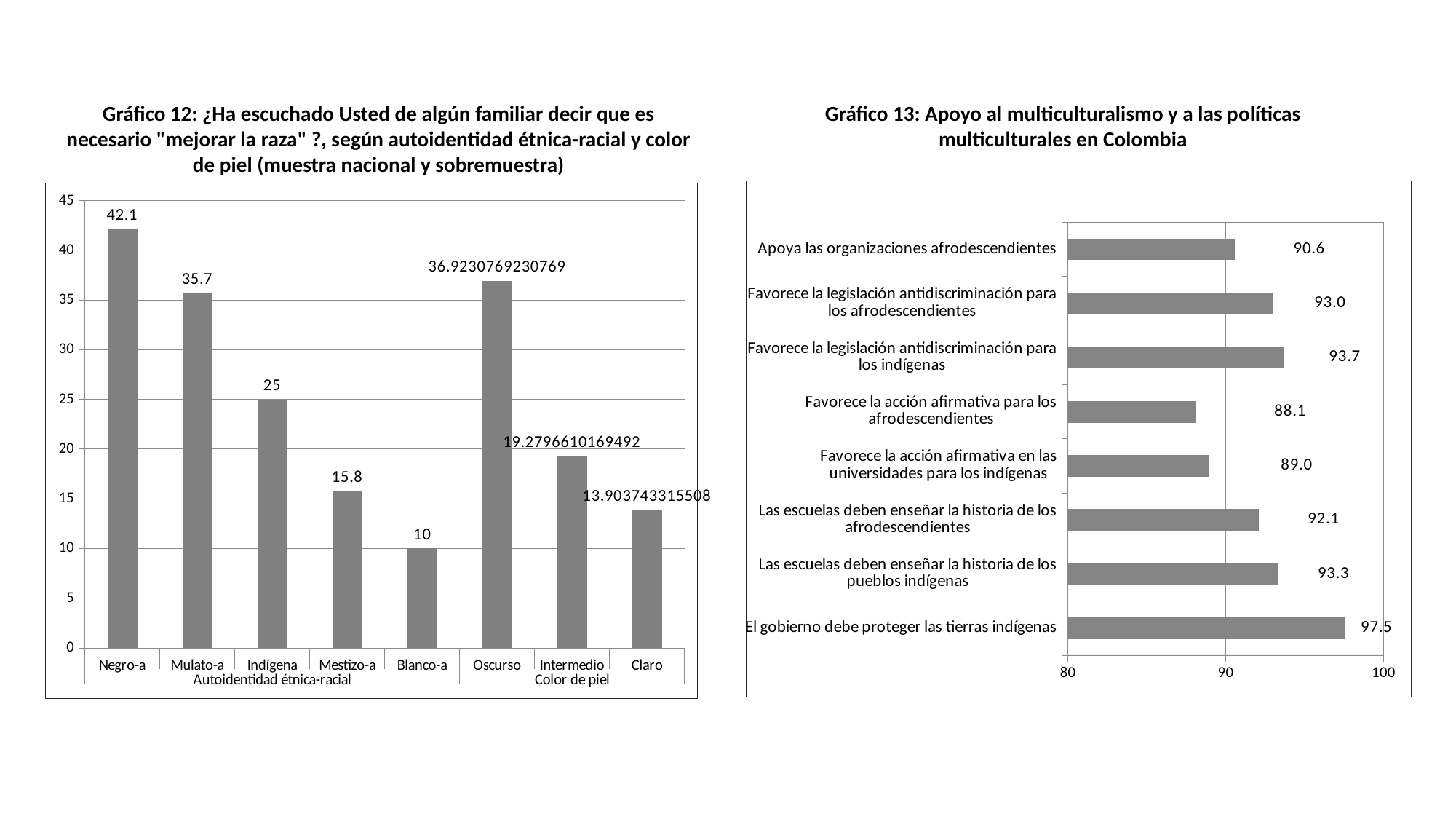
In Gráfico 12, which category has the highest value? Negro-a In Gráfico 12, which category has the lowest value? Blanco-a In Gráfico 12, which is larger, the value for Indígena or the value for Mestizo-a? Indígena In Gráfico 12, how many categories are plotted? 8 In Gráfico 13, how many categories are plotted? 8 In Gráfico 13, what is the value for 'El gobierno debe proteger las tierras indígenas'? 97.5 In Gráfico 13, what is the difference between 'Favorece la legislación antidiscriminación para los indígenas' and 'Favorece la legislación antidiscriminación para los afrodescendientes'? 0.7 In Gráfico 13, which category has the lowest value? Favorece la acción afirmativa para los afrodescendientes In Gráfico 12, what is the value for Blanco-a? 10 In Gráfico 12, what is the value for Negro-a? 42.1 What kind of chart is Gráfico 13? Bar chart In Gráfico 12, what is the difference between the values for Negro-a and Mulato-a? 6.4